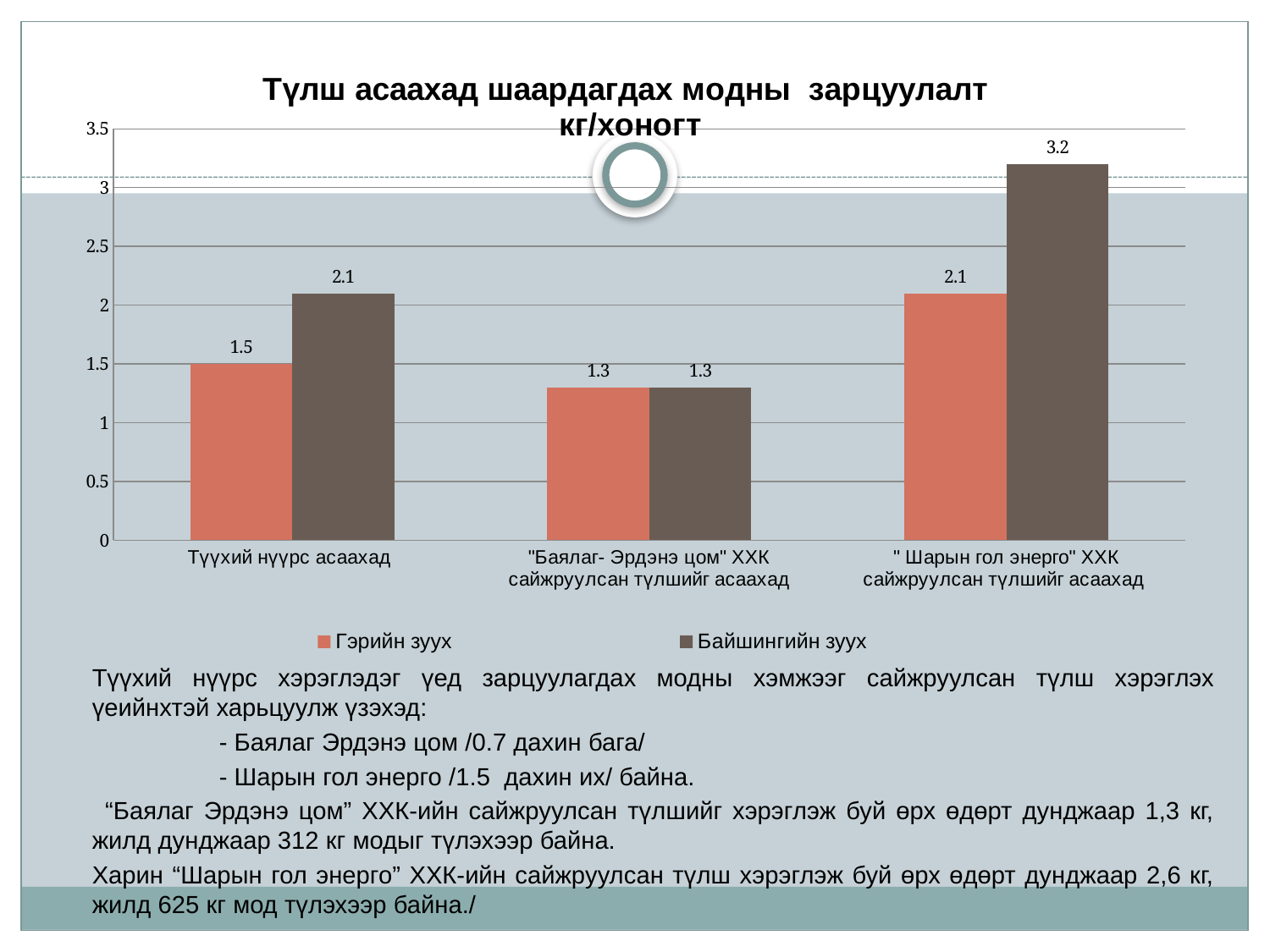
What is the title of the chart? Түлш асаахад шаардагдах модны зарцуулалт кг/хоногт Which category has the highest value for "Байшингийн зуух"? " Шарын гол энерго" ХХК сайжруулсан түлшийг асаахад How many series does the legend list? 2 How many categories are shown on the x axis? 3 What is the value for "Гэрийн зуух" in the category "Түүхий нүүрс асаахад"? 1.5 What is the value for "Байшингийн зуух" in the category "Түүхий нүүрс асаахад"? 2.1 Which category has the lowest value for "Гэрийн зуух"? "Баялаг- Эрдэнэ цом" ХХК сайжруулсан түлшийг асаахад What is the value for "Байшингийн зуух" in the category "" Шарын гол энерго" ХХК сайжруулсан түлшийг асаахад"? 3.2 What type of chart is shown on the slide? bar chart What is the difference between the "Байшингийн зуух" and "Гэрийн зуух" values in the category "" Шарын гол энерго" ХХК сайжруулсан түлшийг асаахад"? 1.1 What is the value for "Гэрийн зуух" in the category ""Баялаг- Эрдэнэ цом" ХХК сайжруулсан түлшийг асаахад"? 1.3 Which is larger in the category "Түүхий нүүрс асаахад": the value for "Гэрийн зуух" or for "Байшингийн зуух"? Байшингийн зуух